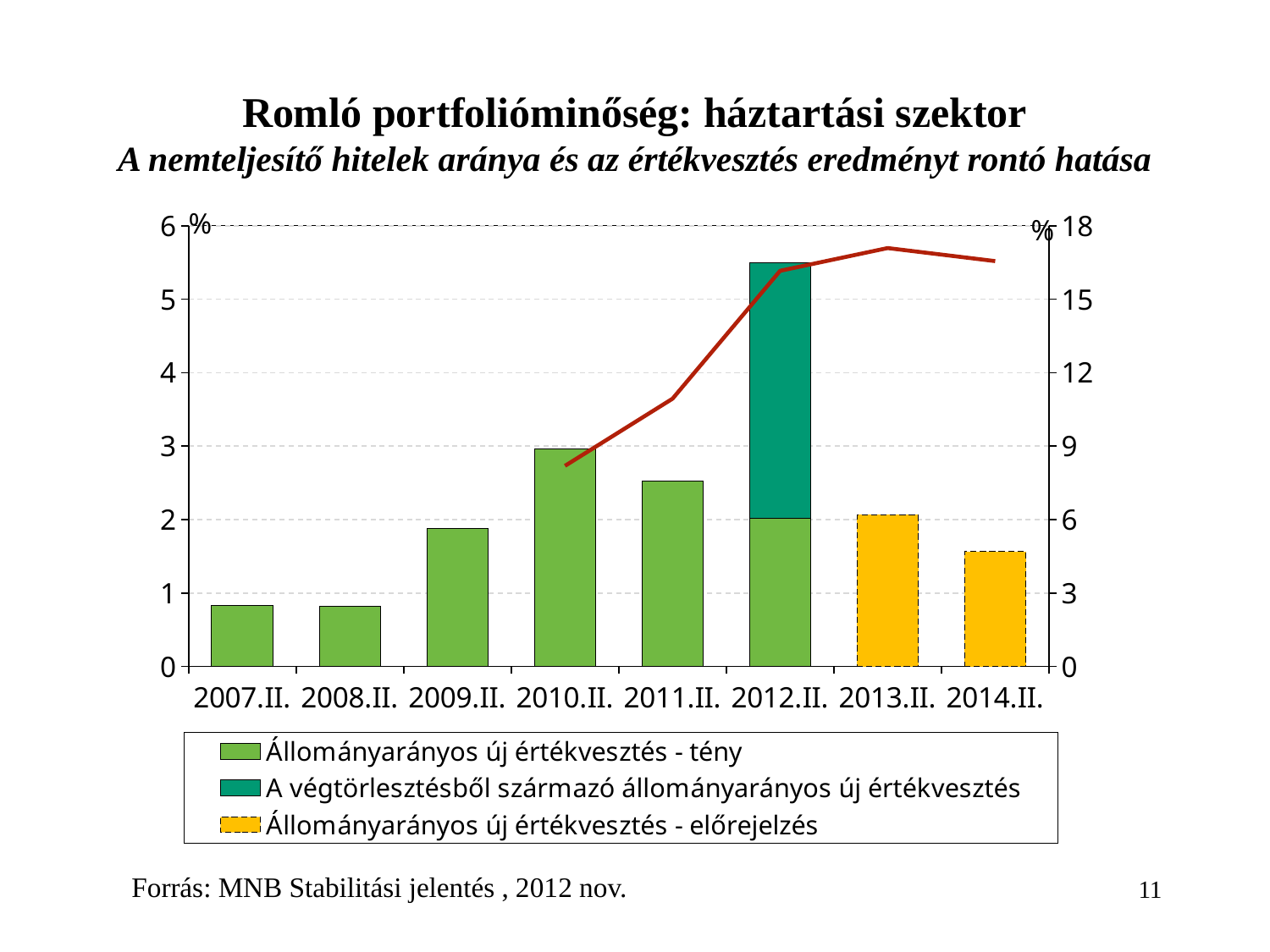
Is the bar for 2007.II. greater or less than 1 on the left axis? less How many time periods are shown on the x axis? 8 Is the total height of the stacked bar for 2012.II. greater or less than 5 on the left axis? greater Is the bar for 2014.II. greater or less than 2 on the left axis? less Which period has the tallest bar? 2012.II. What is the main title of the slide? Romló portfolióminőség: háztartási szektor How many series does the legend list? 3 Does the red line rise or fall between 2010.II. and 2012.II.? rise What kind of chart is shown on the slide? bar chart with a line Which legend entry corresponds to the dashed yellow bars? Állományarányos új értékvesztés - előrejelzés Which bar is taller, 2010.II. or 2011.II.? 2010.II.